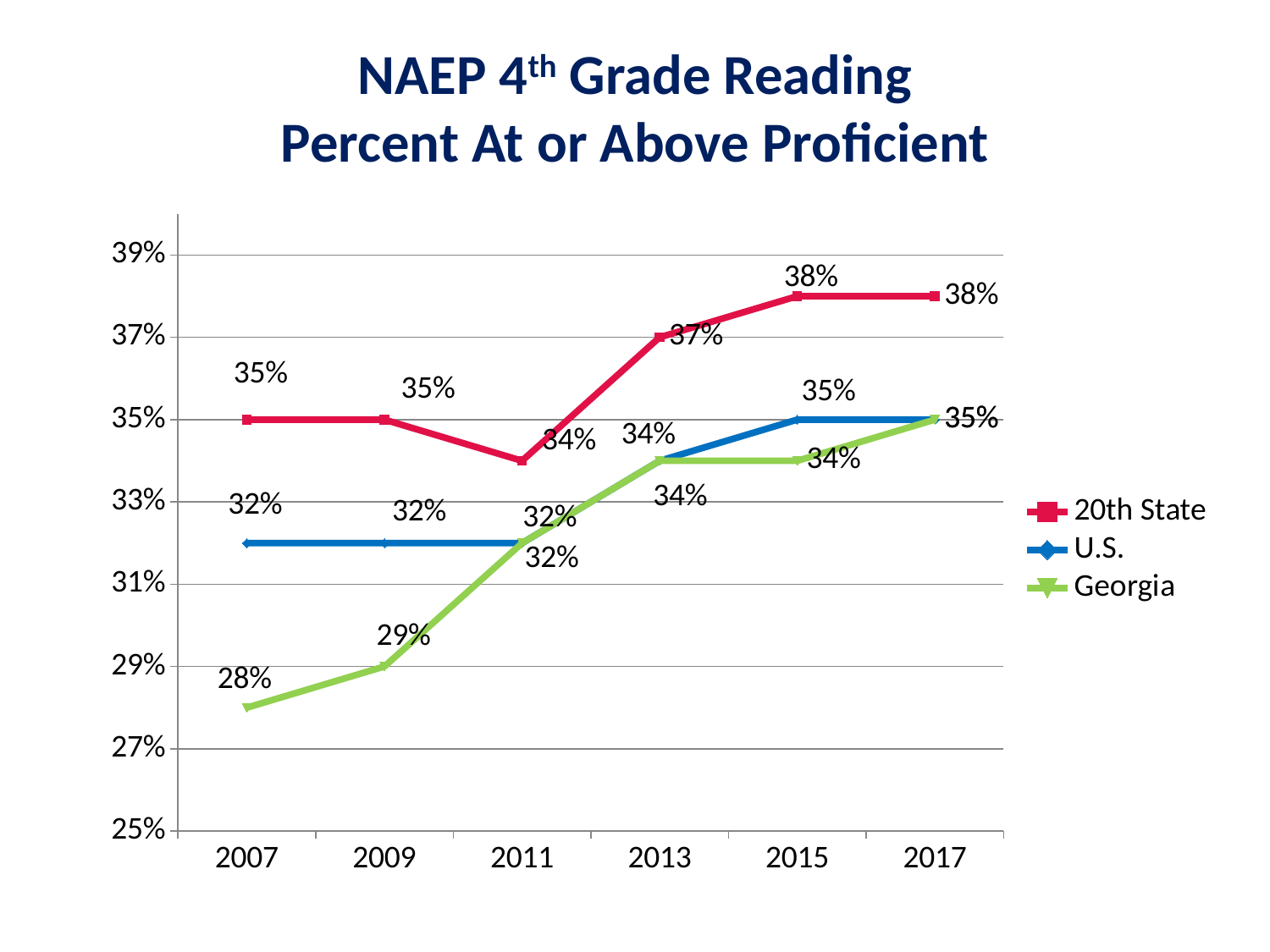
What was Georgia's percent at or above proficient in 2007? 28% What was Georgia's value in 2009? 29% How many series does the legend list? 3 In which year was Georgia's value lowest? 2007 Which was higher in 2015, the U.S. value or Georgia's value? U.S. What was the 20th State value in 2015? 38% What type of chart is shown on the slide? Line chart Does Georgia's line generally rise or fall from 2007 to 2017? Rise Which series is shown in red? 20th State What was the U.S. value in 2013? 34% How many years are plotted along the x axis? 6 What is the difference between the 20th State value and Georgia's value in 2007? 7 percentage points